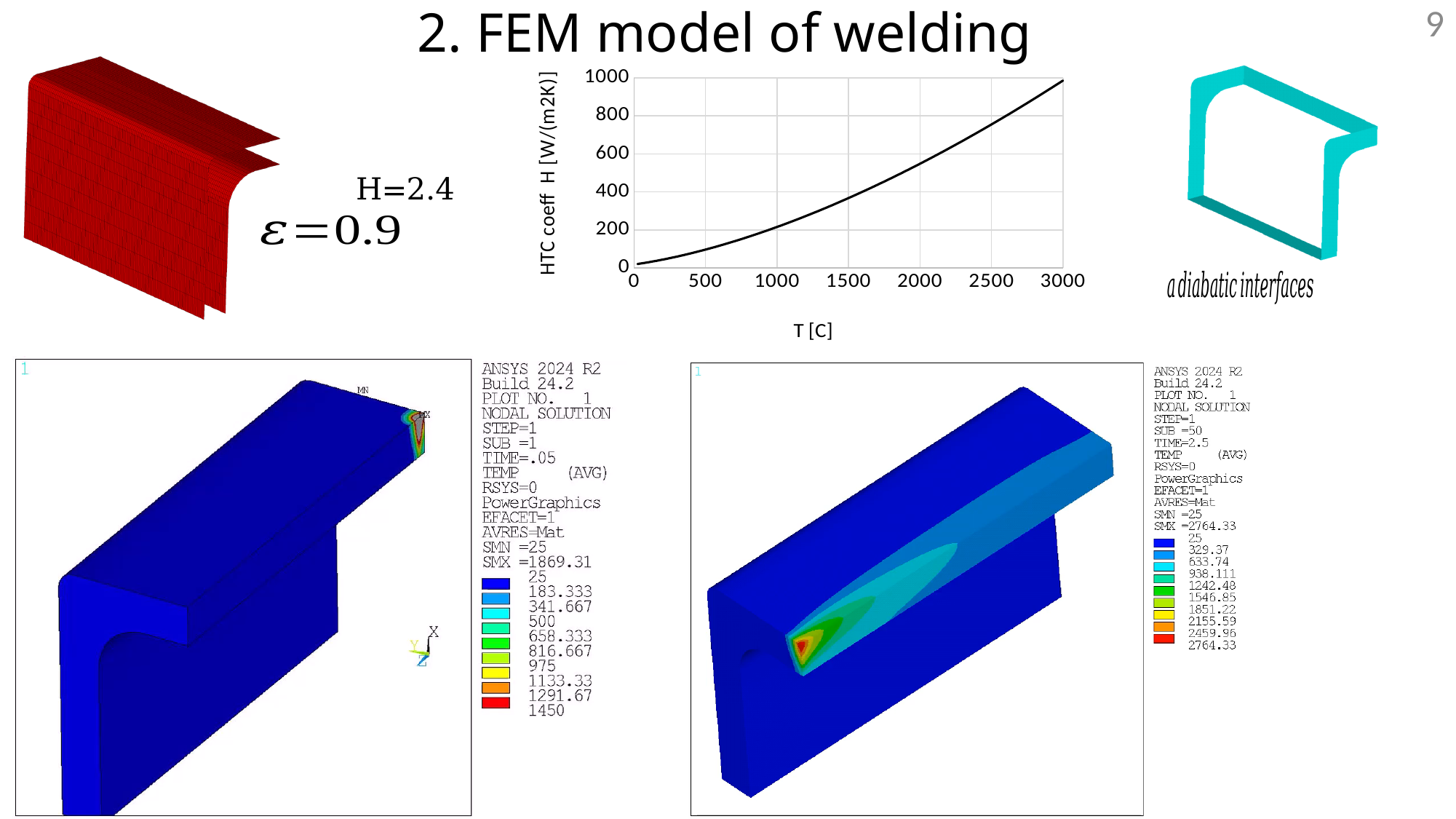
In the HTC coeff H vs T line chart, is the value at T = 2000 greater or less than 400? greater In the HTC coeff H vs T line chart, is the value at T = 500 greater or less than 200? less In the HTC coeff H vs T line chart, is the value at T = 3000 greater or less than 800? greater What is the label of the horizontal axis in the line chart at the top of the slide? T [C] How many lines (series) are plotted in the HTC coeff H vs T line chart? 1 In the HTC coeff H vs T line chart, does the value rise or fall as T increases? rises What is the label of the vertical axis in the line chart at the top of the slide? HTC coeff H [W/(m2K)] What kind of chart is the plot of HTC coeff H against T at the top of the slide? line chart